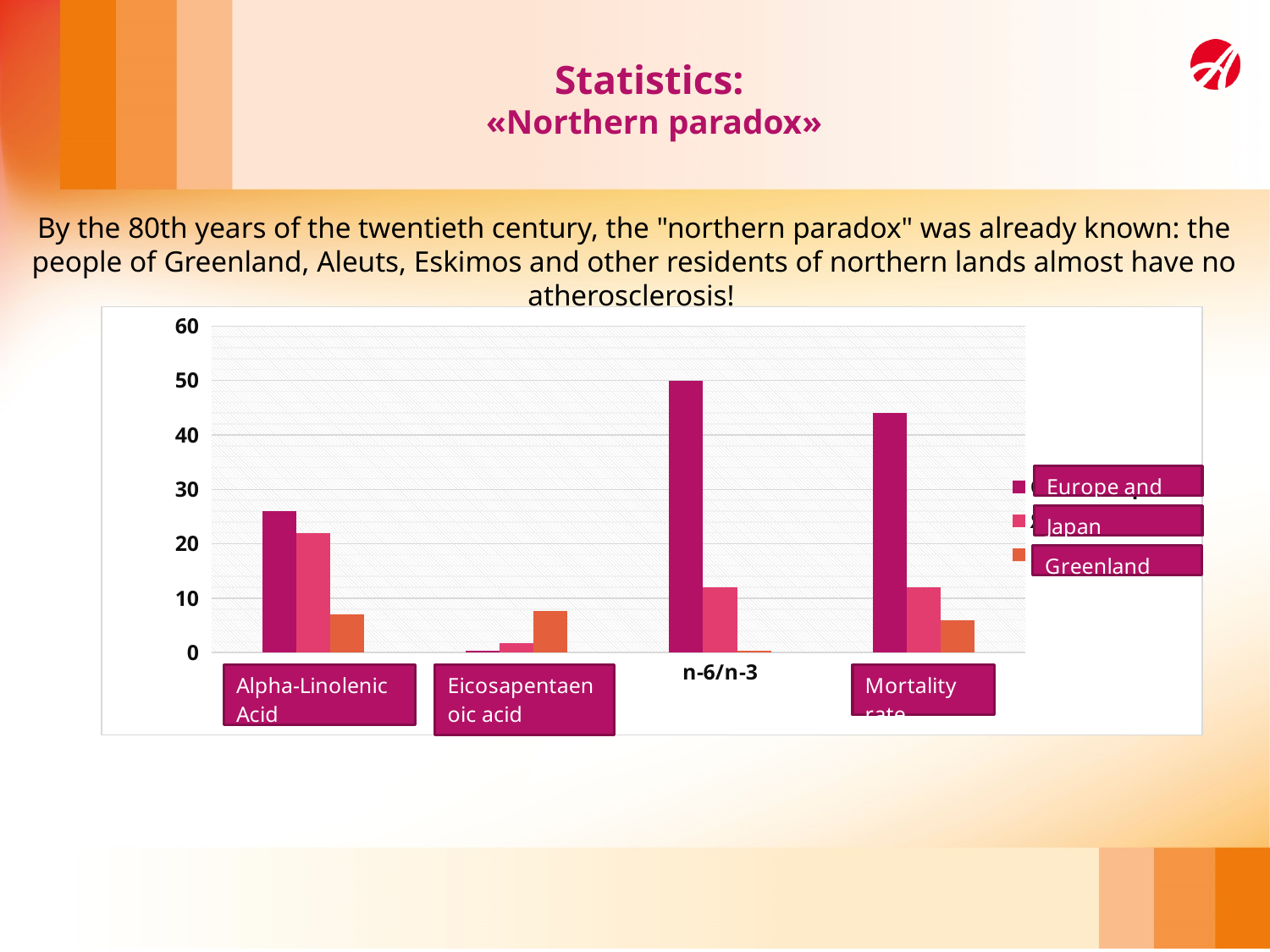
How many categories are shown on the x axis of the chart? 4 How many series does the chart's legend list? 3 For which category is the Greenland bar the lowest? n-6/n-3 What kind of chart is shown on the slide? bar chart Is the Greenland value for Eicosapentaenoic acid greater or less than 10? less Is the Europe value for Alpha-Linolenic Acid greater or less than 20? greater Is the Japan value for n-6/n-3 greater or less than 10? greater For Mortality rate, which is larger: the Europe value or the Greenland value? Europe For which category is the Europe series bar the highest? n-6/n-3 Which series is drawn in orange in the chart? Greenland